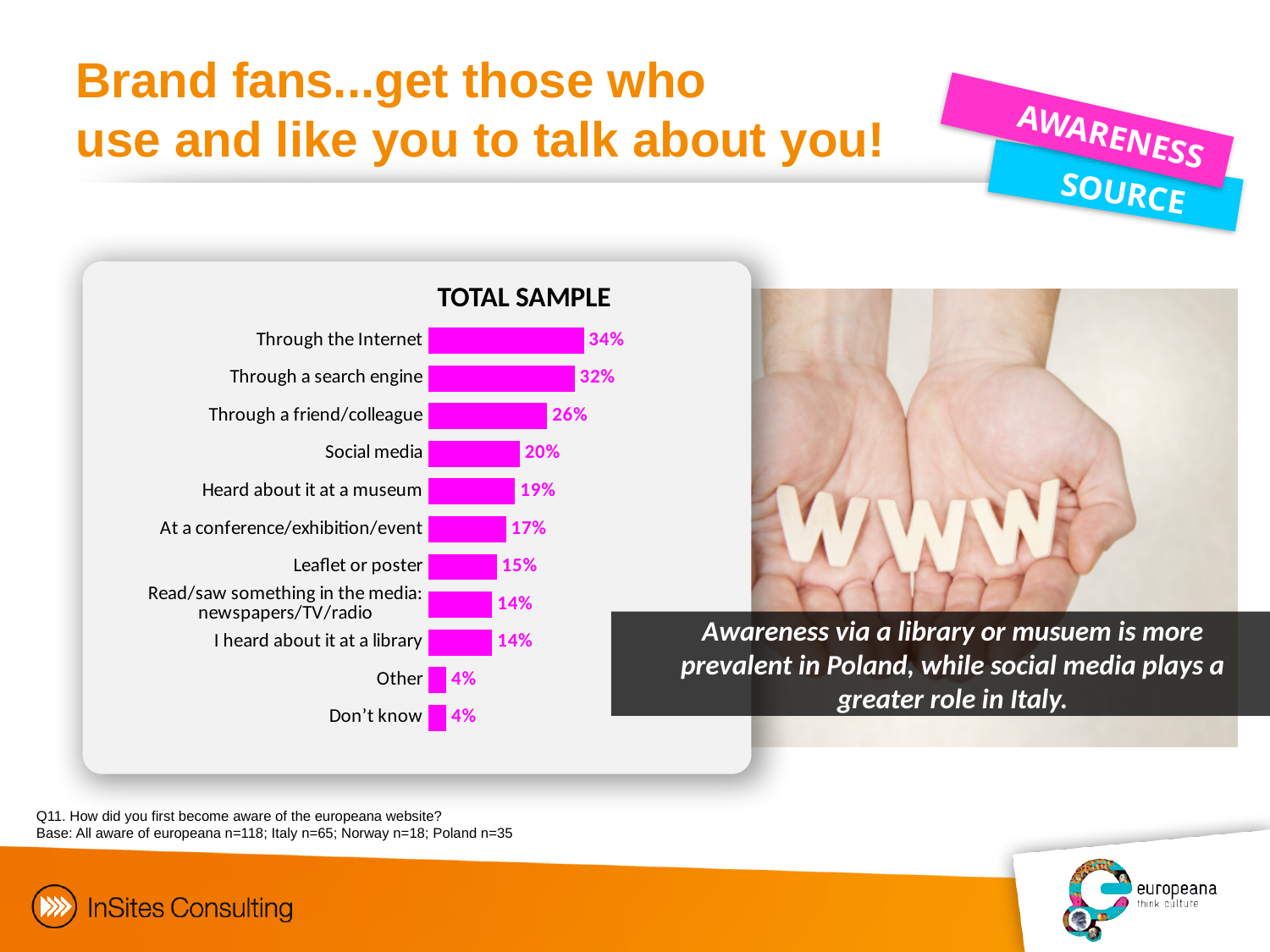
What is the value for 'Through the Internet'? 34% What is the title of the chart? TOTAL SAMPLE Which category has the highest value? Through the Internet How many categories are shown in the chart? 11 What is the value for 'Heard about it at a museum'? 19% What is the value for 'Leaflet or poster'? 15% What kind of chart is shown on the slide? Bar chart Which is larger, 'At a conference/exhibition/event' or 'Leaflet or poster'? At a conference/exhibition/event What is the difference between 'Through the Internet' and 'Through a search engine'? 2% What is the difference between 'Through a friend/colleague' and 'Social media'? 6% What is the value for 'Social media'? 20% Which is larger, 'Social media' or 'I heard about it at a library'? Social media